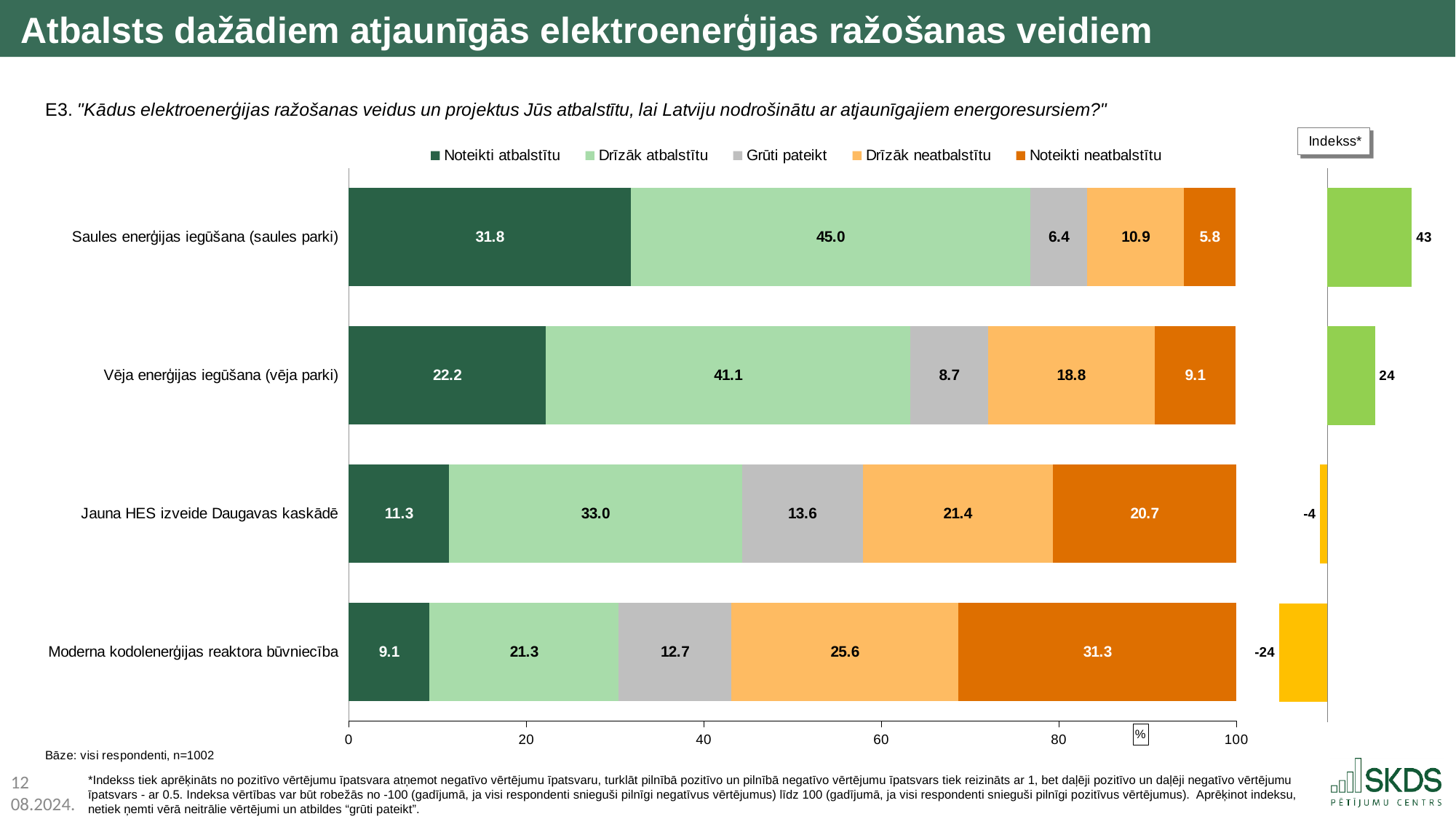
In the main stacked bar chart, what is the 'Noteikti neatbalstītu' value for 'Moderna kodolenerģijas reaktora būvniecība'? 31.3 How many categories are shown in the main stacked bar chart? 4 What kind of chart is the main chart on the slide? Stacked bar chart In the 'Indekss*' chart on the right, what is the index value for 'Vēja enerģijas iegūšana (vēja parki)'? 24 In the main stacked bar chart, which category has the highest 'Drīzāk atbalstītu' value? Saules enerģijas iegūšana (saules parki) In the main stacked bar chart, what is the 'Noteikti atbalstītu' value for 'Saules enerģijas iegūšana (saules parki)'? 31.8 In the main stacked bar chart, what is the 'Grūti pateikt' value for 'Jauna HES izveide Daugavas kaskādē'? 13.6 How many series does the legend of the main stacked bar chart list? 5 In the main stacked bar chart, which is larger: the 'Noteikti neatbalstītu' value for 'Jauna HES izveide Daugavas kaskādē' or for 'Vēja enerģijas iegūšana (vēja parki)'? Jauna HES izveide Daugavas kaskādē In the 'Indekss*' chart on the right, which category has the lowest index value? Moderna kodolenerģijas reaktora būvniecība In the main stacked bar chart, what is the difference between the 'Drīzāk neatbalstītu' values for 'Vēja enerģijas iegūšana (vēja parki)' and 'Saules enerģijas iegūšana (saules parki)'? 7.9 In the main stacked bar chart, which category has the lowest 'Noteikti atbalstītu' value? Moderna kodolenerģijas reaktora būvniecība